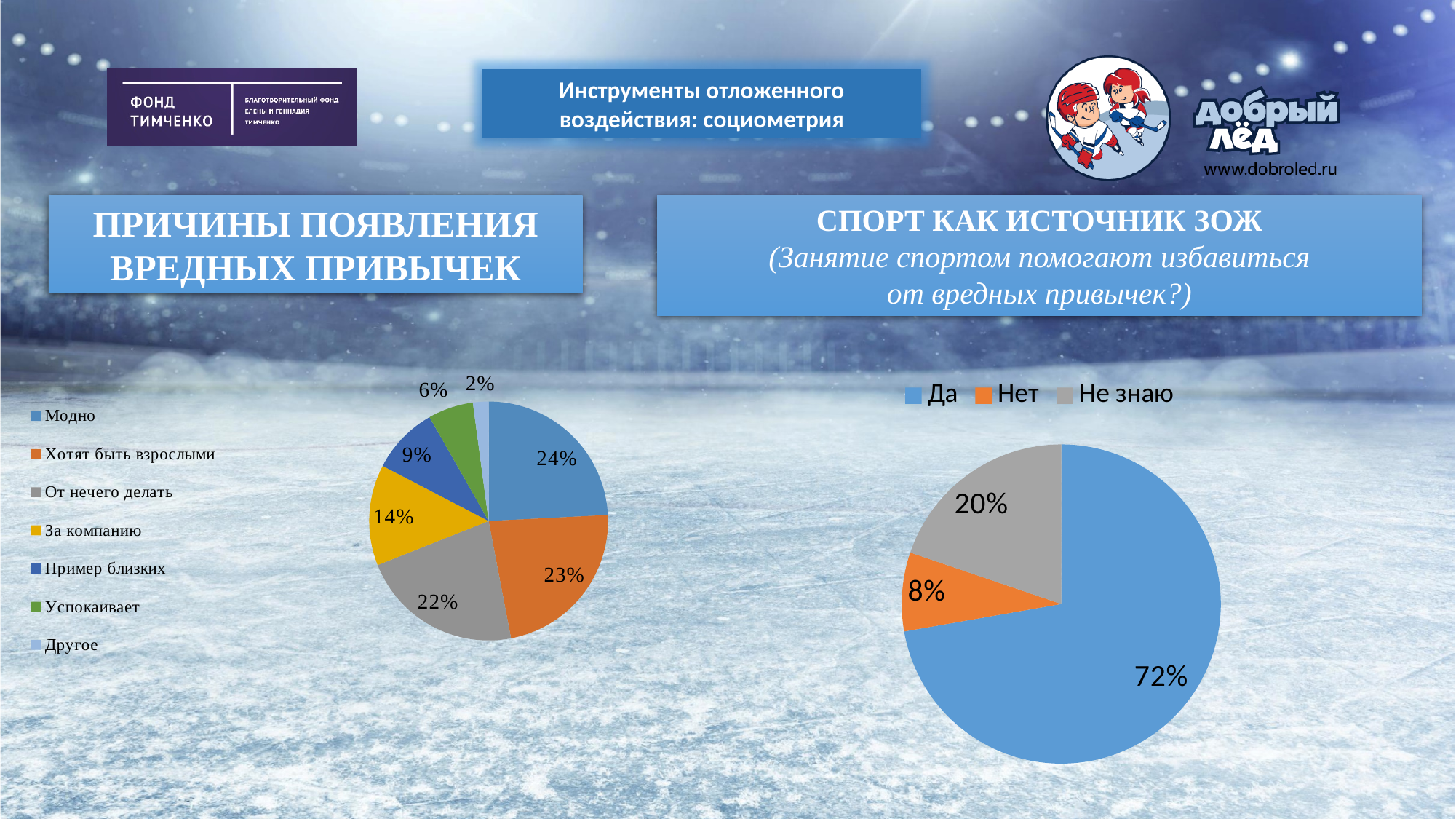
In the right chart 'СПОРТ КАК ИСТОЧНИК ЗОЖ', what share is labelled for 'Да'? 72% In the left chart 'ПРИЧИНЫ ПОЯВЛЕНИЯ ВРЕДНЫХ ПРИВЫЧЕК', which category has the largest share? Модно In the left chart 'ПРИЧИНЫ ПОЯВЛЕНИЯ ВРЕДНЫХ ПРИВЫЧЕК', what share is labelled for 'За компанию'? 14% In the left chart 'ПРИЧИНЫ ПОЯВЛЕНИЯ ВРЕДНЫХ ПРИВЫЧЕК', what share is labelled for 'Модно'? 24% What type of chart is the right chart 'СПОРТ КАК ИСТОЧНИК ЗОЖ'? Pie chart In the left chart 'ПРИЧИНЫ ПОЯВЛЕНИЯ ВРЕДНЫХ ПРИВЫЧЕК', what is the difference between 'За компанию' and 'Успокаивает'? 8% In the left chart 'ПРИЧИНЫ ПОЯВЛЕНИЯ ВРЕДНЫХ ПРИВЫЧЕК', how many categories does the legend list? 7 In the right chart 'СПОРТ КАК ИСТОЧНИК ЗОЖ', which is larger, 'Не знаю' or 'Нет'? Не знаю In the left chart 'ПРИЧИНЫ ПОЯВЛЕНИЯ ВРЕДНЫХ ПРИВЫЧЕК', what share is labelled for 'Пример близких'? 9% In the right chart 'СПОРТ КАК ИСТОЧНИК ЗОЖ', what is the difference between 'Да' and 'Не знаю'? 52% In the left chart 'ПРИЧИНЫ ПОЯВЛЕНИЯ ВРЕДНЫХ ПРИВЫЧЕК', which category has the smallest share? Другое In the right chart 'СПОРТ КАК ИСТОЧНИК ЗОЖ', what share is labelled for 'Нет'? 8%